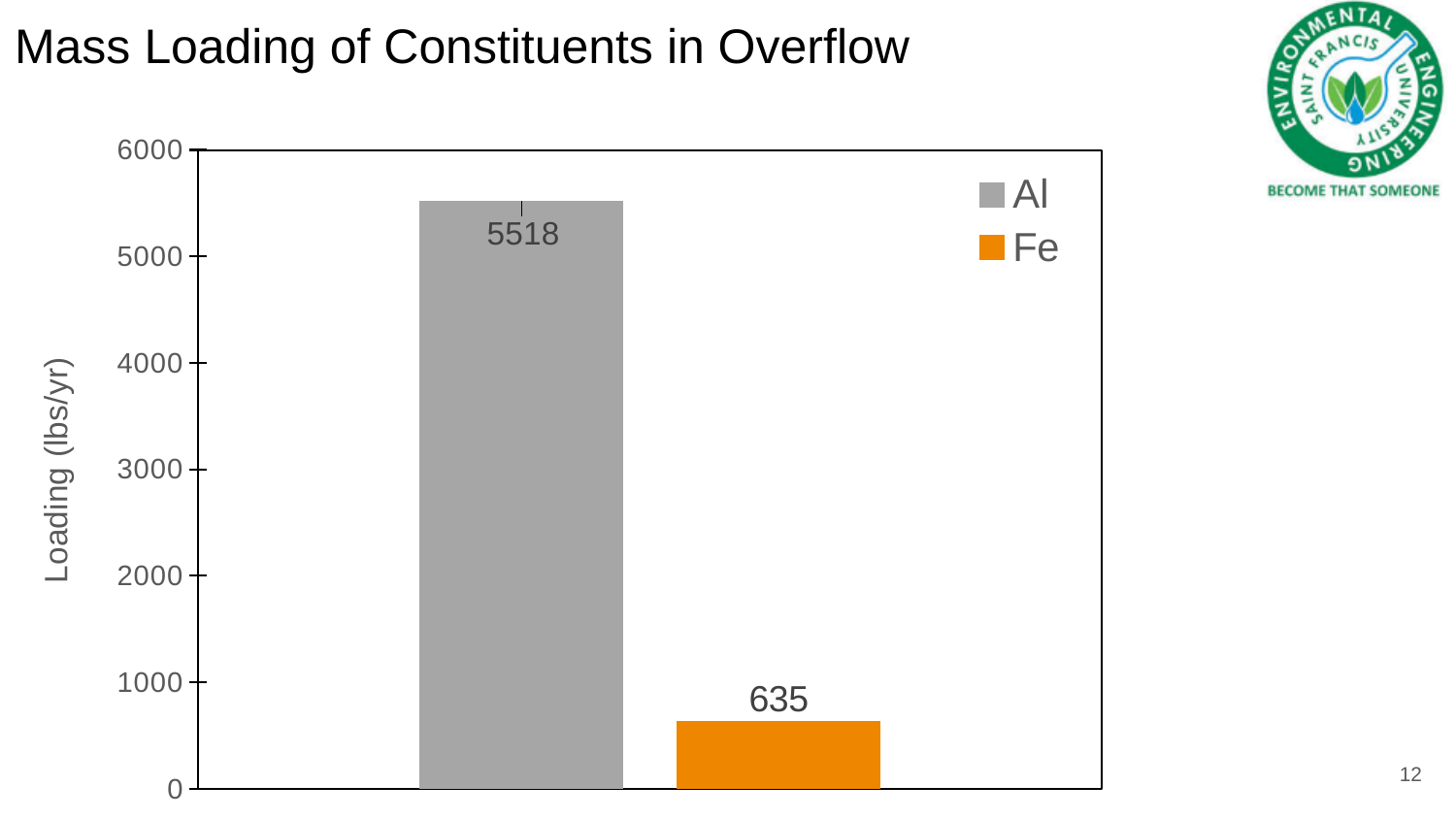
What is the label of the y axis? Loading (lbs/yr) Which constituent has the highest loading? Al What is the difference in loading between Al and Fe? 4883 Is the loading for Al greater or less than 5000? greater How many entries does the legend list? 2 What type of chart is shown on the slide? Bar chart How many bars are plotted in the chart? 2 Which constituent has the lowest loading? Fe Which has a larger loading, Al or Fe? Al What is the loading value for Fe? 635 What is the loading value for Al? 5518 Is the loading for Fe greater or less than 1000? less